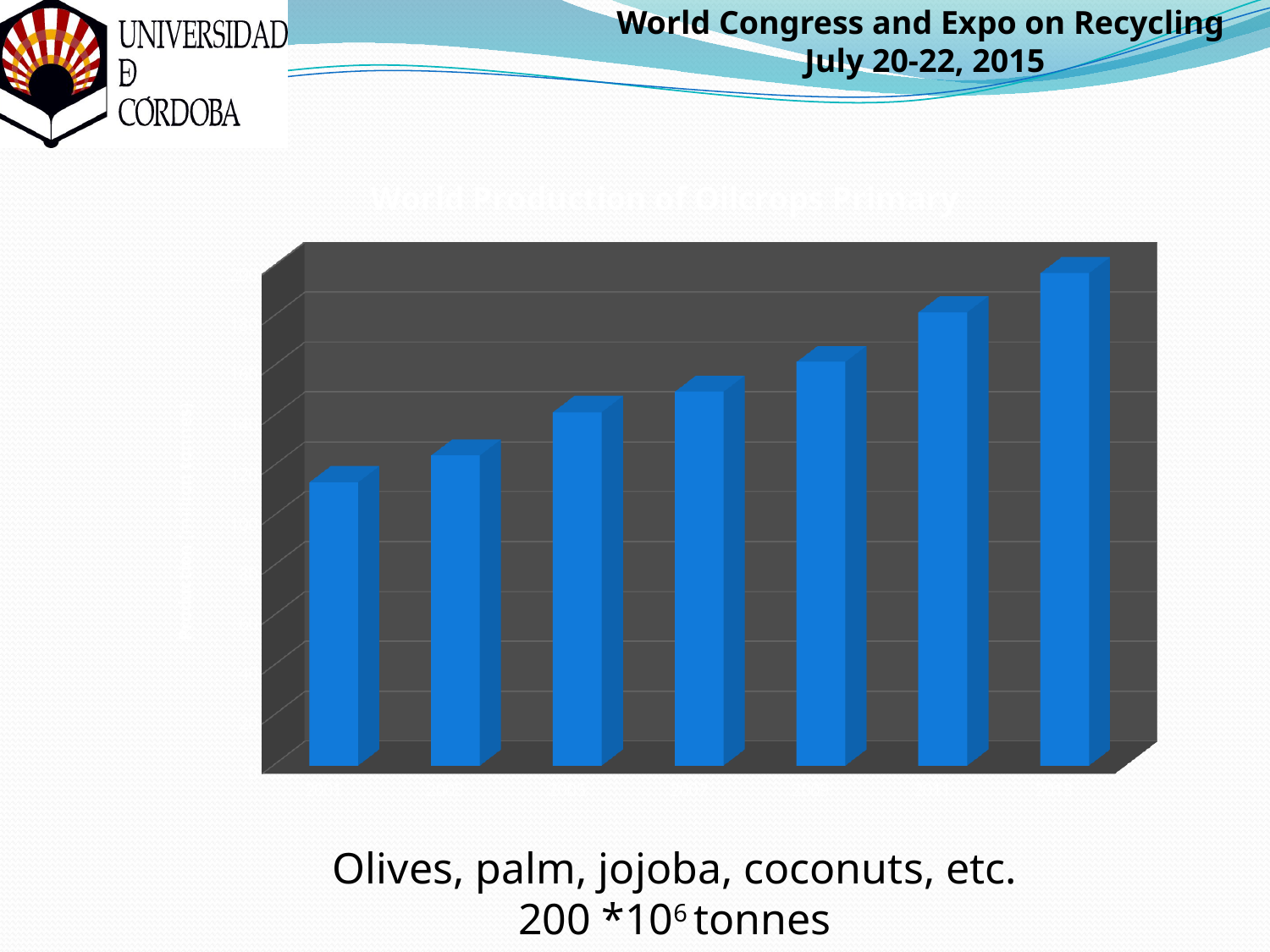
Which is larger, the value of the sixth bar from the left or the value of the third bar from the left? the sixth bar from the left Which bar is the tallest in the chart, the leftmost or the rightmost? the rightmost What kind of chart is shown on the slide? bar chart What colour are the bars in the chart? blue What is the title of the chart? World Production of Oilcrops Primary How many bars are plotted in the chart? 7 Do the bar values rise or fall from left to right across the chart? rise Which bar is the shortest in the chart, the leftmost or the rightmost? the leftmost Which is larger, the value of the second bar from the left or the value of the fourth bar from the left? the fourth bar from the left